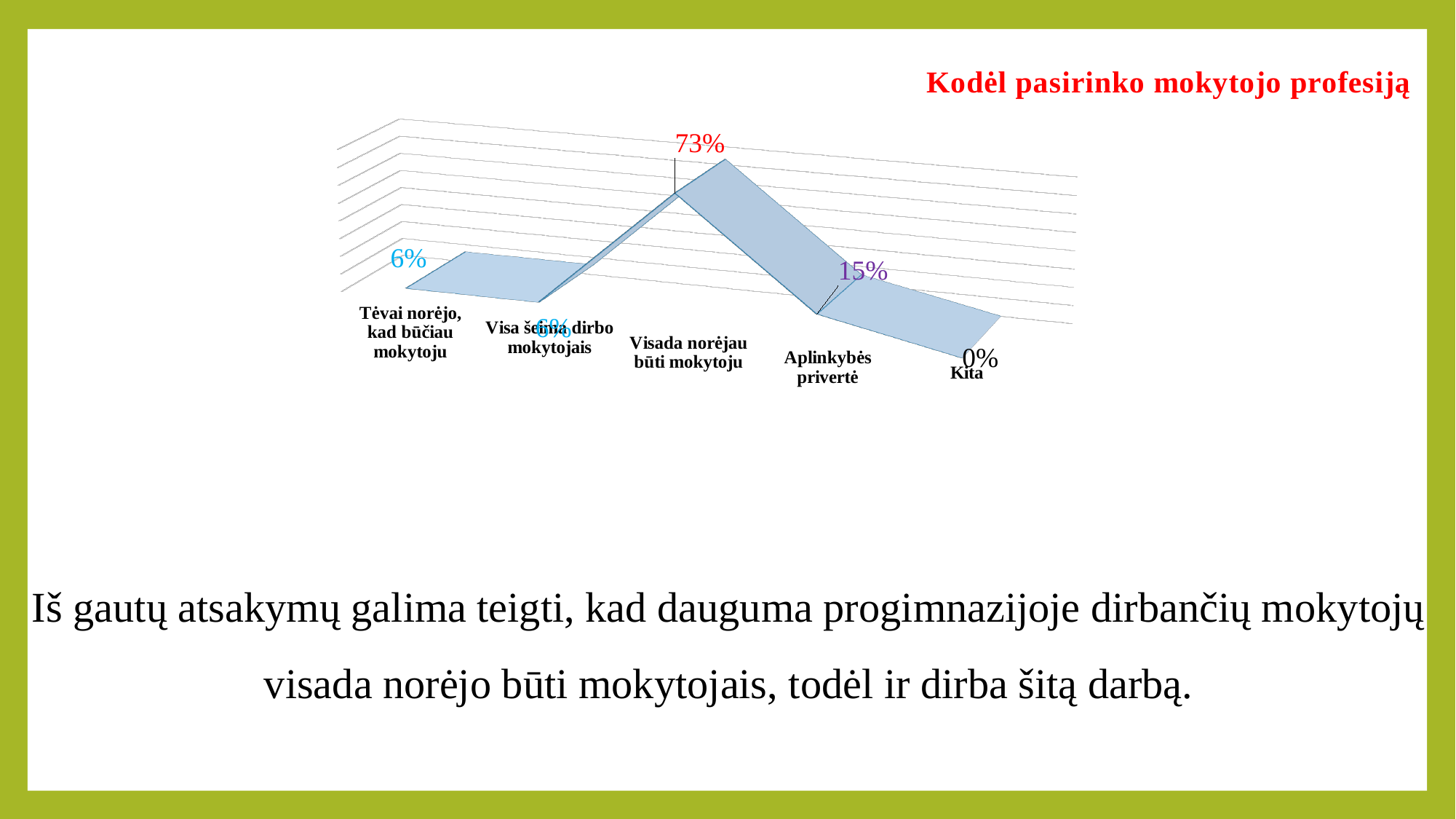
What is the value for "Kita"? 0% What is the value for "Tėvai norėjo, kad būčiau mokytoju"? 6% Which category has the highest value? Visada norėjau būti mokytoju What is the difference between the values for "Visada norėjau būti mokytoju" and "Aplinkybės privertė"? 58% Which is larger, the value for "Aplinkybės privertė" or the value for "Visa šeima dirbo mokytojais"? Aplinkybės privertė What is the value for "Visada norėjau būti mokytoju"? 73% What is the title of the chart? Kodėl pasirinko mokytojo profesiją How many categories are shown on the chart? 5 Do the values rise or fall from "Visada norėjau būti mokytoju" to "Kita"? Fall What kind of chart is shown on the slide? Line chart Which category has the lowest value? Kita What is the value for "Aplinkybės privertė"? 15%